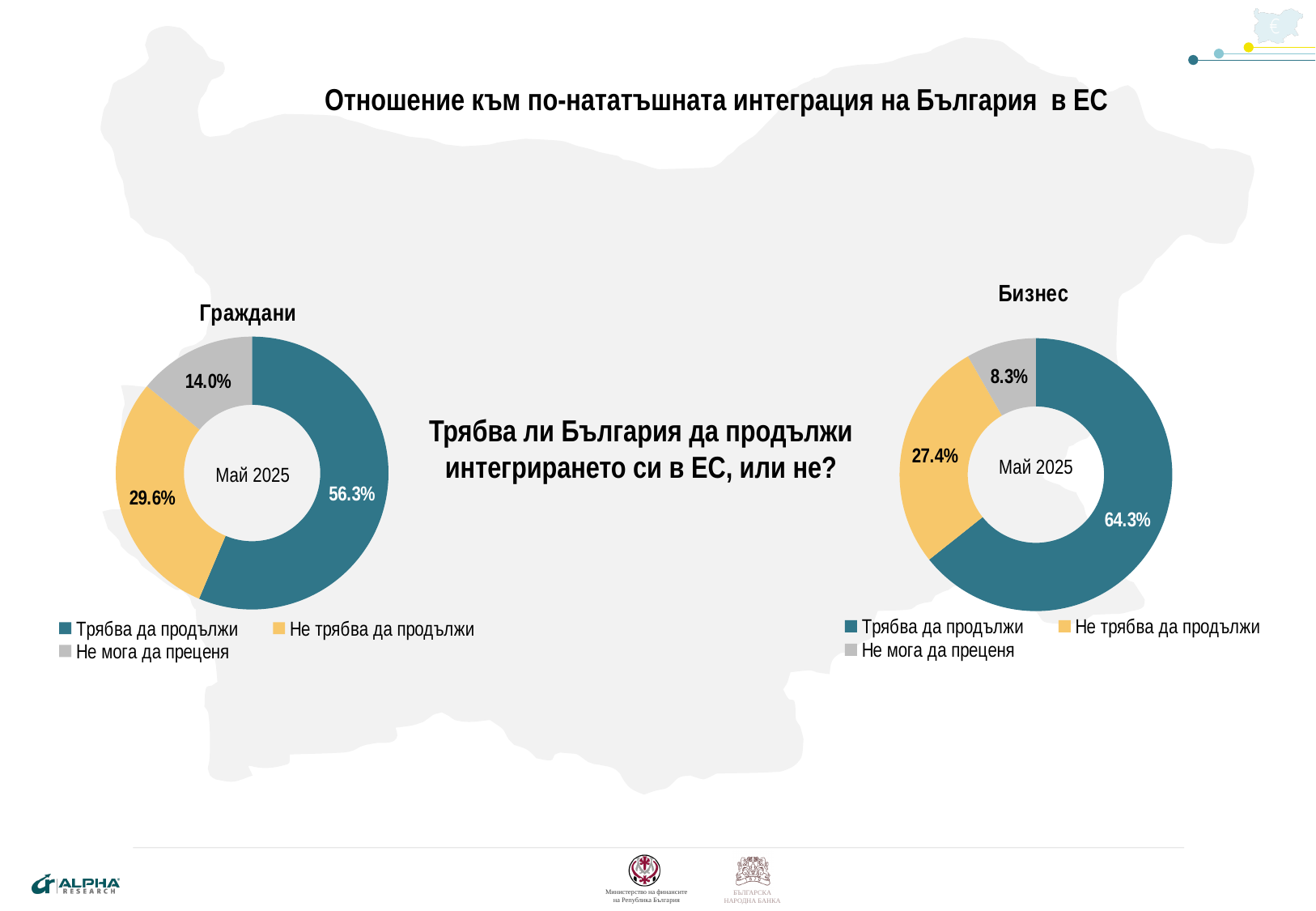
What is the difference between the "Трябва да продължи" share in the "Бизнес" chart and in the "Граждани" chart? 8.0% In the "Граждани" chart, what is the combined share of "Не трябва да продължи" and "Не мога да преценя"? 43.6% In the "Граждани" chart, which category has the smallest share? Не мога да преценя In the "Бизнес" chart, which category has the largest share? Трябва да продължи In the "Граждани" chart, what is the value for "Не мога да преценя"? 14.0% In the "Бизнес" chart, what share of respondents answered "Не трябва да продължи"? 27.4% What type of chart is used for the "Бизнес" data? Donut (pie) chart In the "Граждани" chart, what share of respondents answered "Трябва да продължи"? 56.3% Which chart shows a larger share for "Не трябва да продължи", "Граждани" or "Бизнес"? Граждани How many categories does the "Граждани" chart show? 3 What date is shown in the centre of both donut charts? Май 2025 In the "Бизнес" chart, what is the value for "Не мога да преценя"? 8.3%